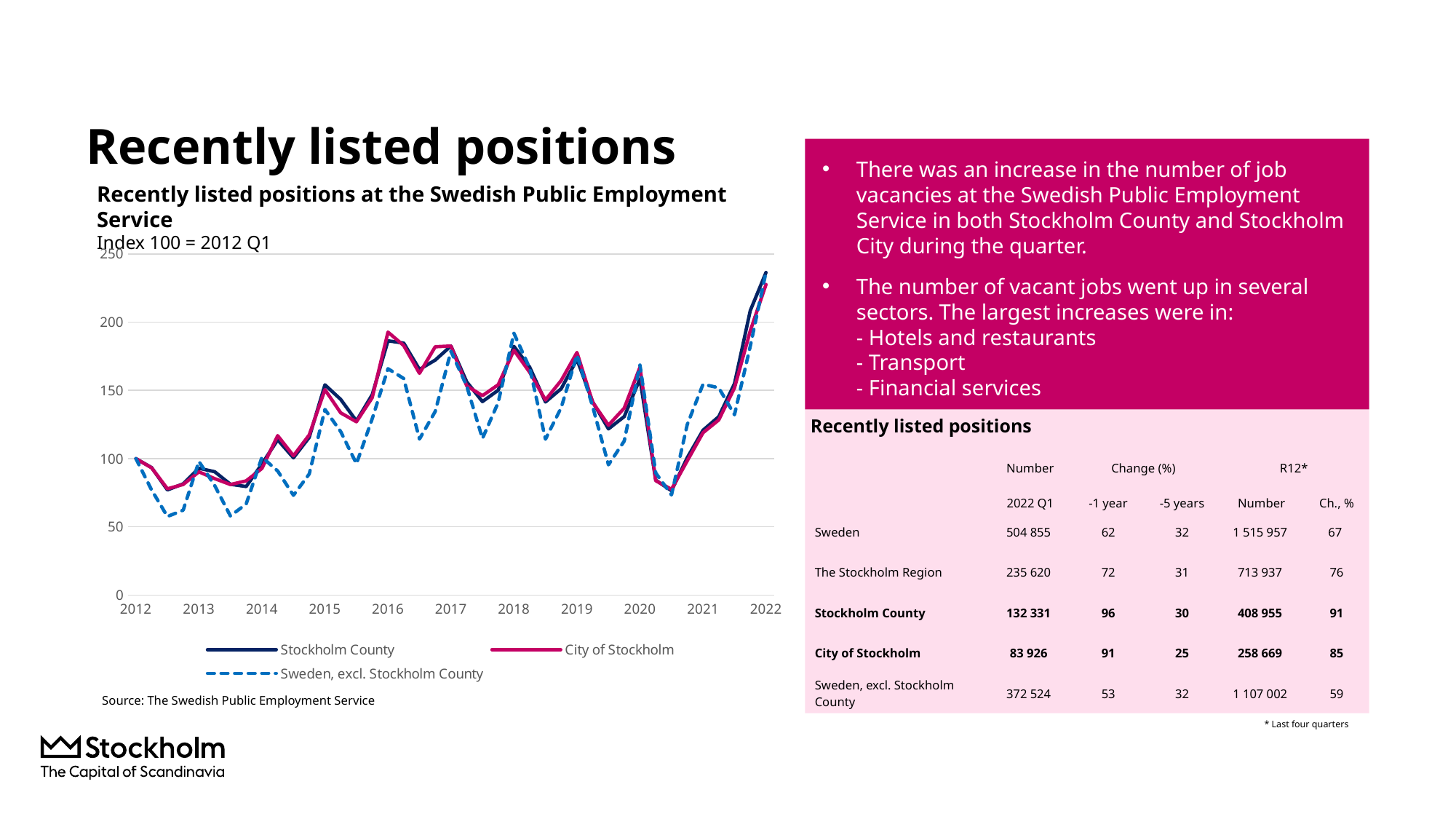
What kind of chart is shown on the slide? Line chart What is the index base stated under the chart title? Index 100 = 2012 Q1 Is the value for Sweden, excl. Stockholm County at its 2013 low point greater or less than 100? less Which series is drawn with a dashed line in the chart? Sweden, excl. Stockholm County How many year labels are shown on the x axis of the chart? 11 How many series does the chart legend list? 3 Is the value for City of Stockholm at its 2016 peak greater or less than 150? greater Overall, do the index values rise or fall from 2012 to 2022? Rise Is the value for Stockholm County at the end of 2022 greater or less than 200? greater At the 2016 peak, which is higher: City of Stockholm or Sweden, excl. Stockholm County? City of Stockholm